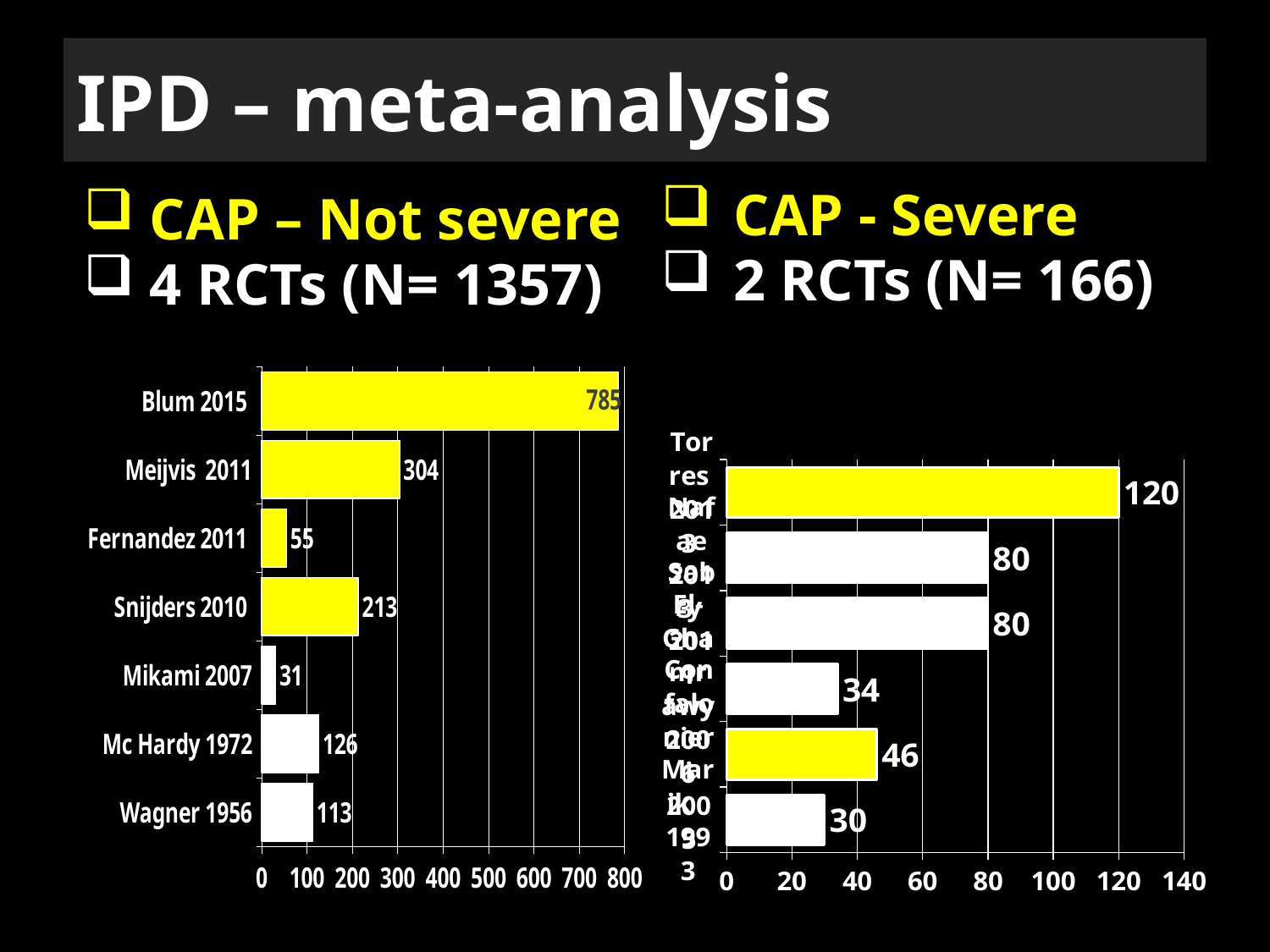
What kind of chart is the left chart (CAP – Not severe)? Bar chart On the left chart (CAP – Not severe), what is the value for Mc Hardy 1972? 126 On the left chart (CAP – Not severe), which study has the highest value? Blum 2015 On the left chart (CAP – Not severe), which study has the lowest value? Mikami 2007 On the left chart (CAP – Not severe), what is the difference between the values for Meijvis 2011 and Fernandez 2011? 249 On the left chart (CAP – Not severe), what is the value for Blum 2015? 785 On the right chart (CAP - Severe), what is the largest value shown on any bar? 120 On the right chart (CAP - Severe), what is the smallest value shown on any bar? 30 On the right chart (CAP - Severe), how many bars are plotted? 6 On the left chart (CAP – Not severe), what is the value for Snijders 2010? 213 On the left chart (CAP – Not severe), which is larger, the value for Mc Hardy 1972 or Wagner 1956? Mc Hardy 1972 On the left chart (CAP – Not severe), how many studies are plotted? 7